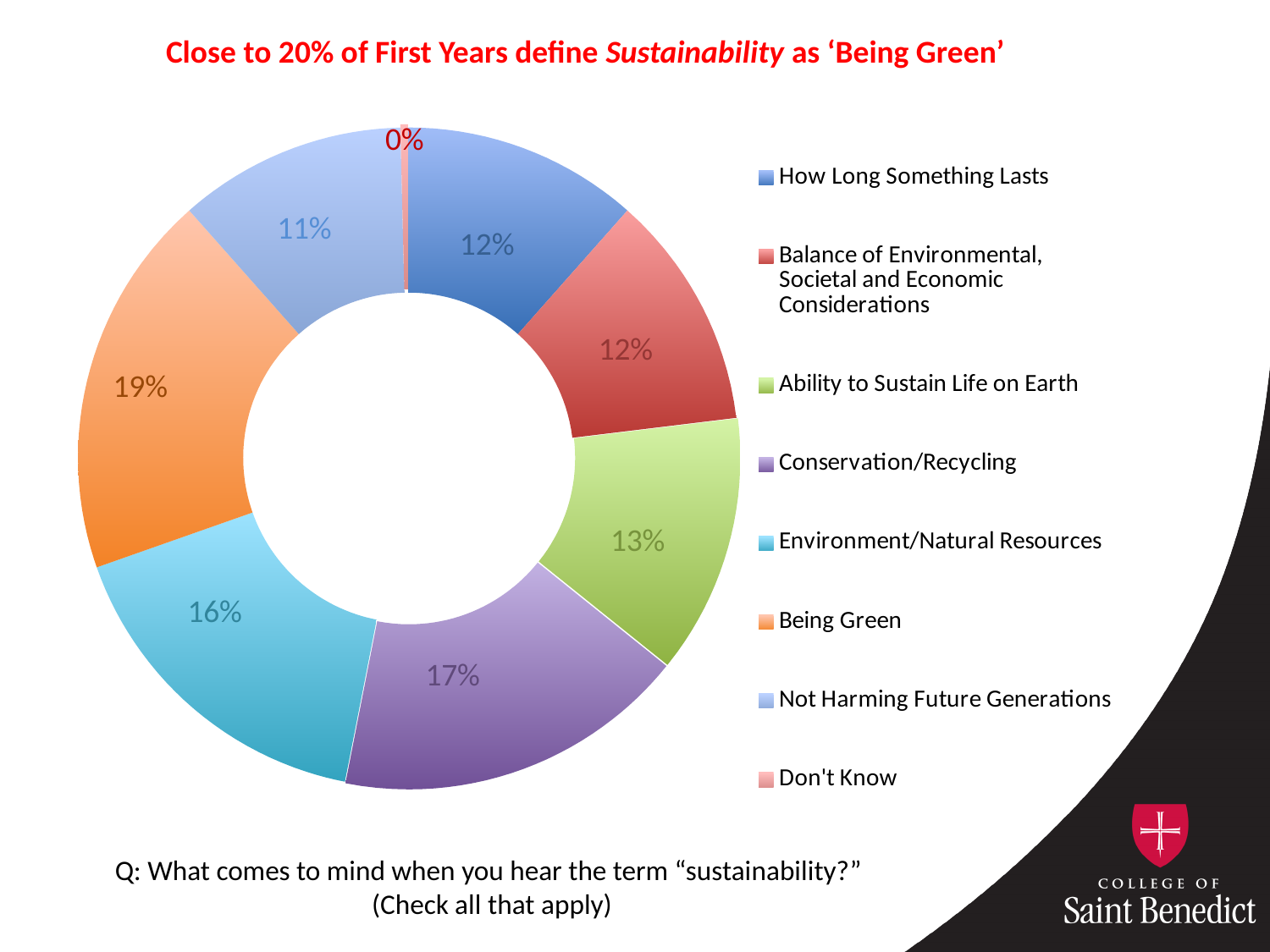
How many categories does the chart's legend list? 8 What percentage is shown for 'Ability to Sustain Life on Earth'? 13% Which category has the largest share of the chart? Being Green What is the difference in percentage points between 'Being Green' and 'Not Harming Future Generations'? 8% What percentage is shown for 'Environment/Natural Resources'? 16% Which category has the smallest share of the chart? Don't Know What percentage is shown for 'Conservation/Recycling'? 17% What percentage of first years define sustainability as 'Being Green'? 19% What kind of chart is shown on the slide? Doughnut (pie) chart What colour is the 'Being Green' segment of the chart? Orange What percentage is shown for 'Not Harming Future Generations'? 11% Which has a larger share: 'Conservation/Recycling' or 'Environment/Natural Resources'? Conservation/Recycling